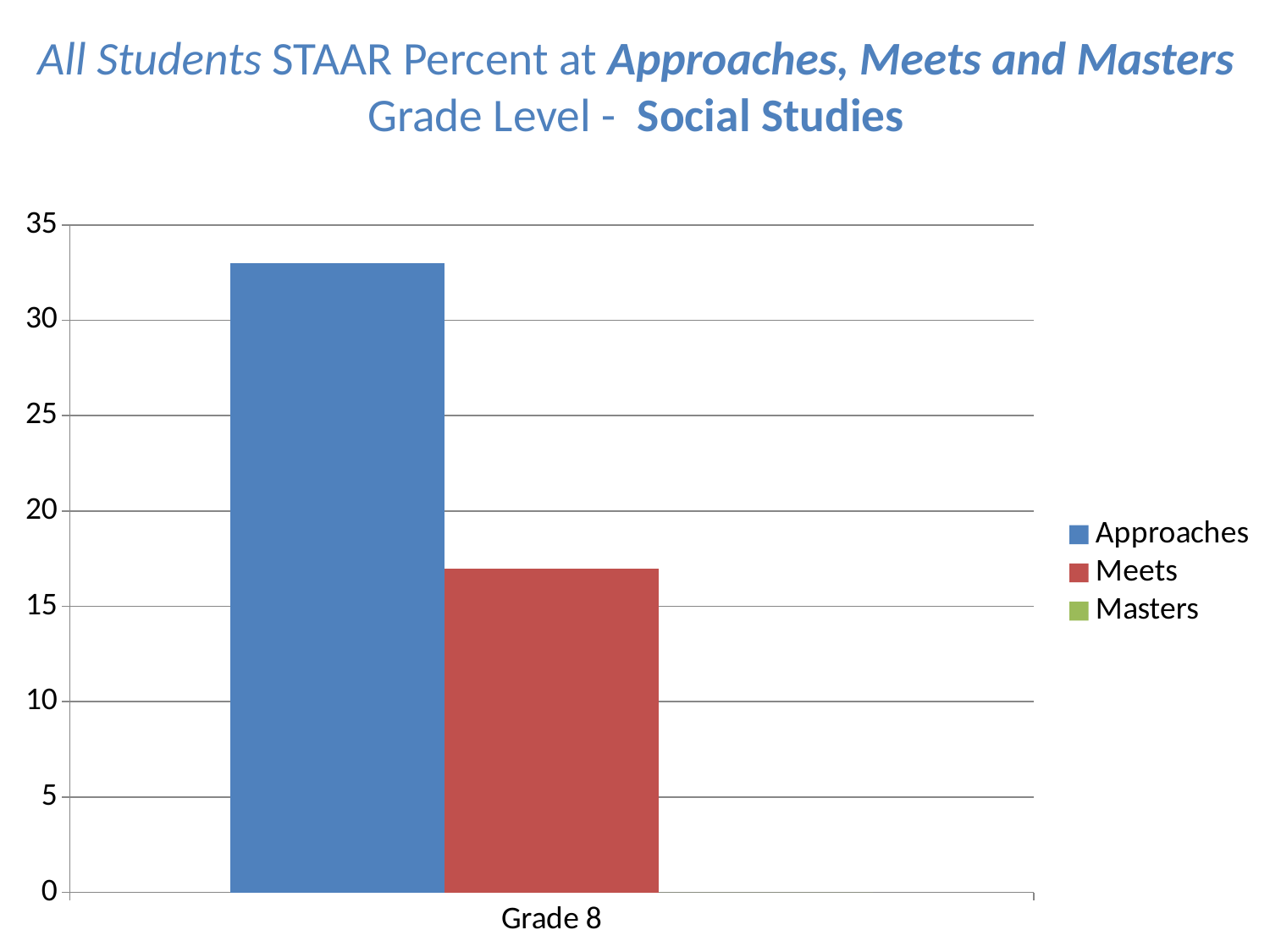
Is the value for Approaches at Grade 8 greater or less than 30? greater How many grade-level categories are shown on the x axis? 1 What colour represents the Meets series in the legend? red What kind of chart is shown on the slide? bar chart Which category label appears on the x axis? Grade 8 Is the value for Approaches at Grade 8 greater or less than 35? less Which subject does the chart title say the STAAR percentages are for? Social Studies Is the value for Meets at Grade 8 greater or less than 15? greater Which series has the tallest bar for Grade 8? Approaches How many series does the legend list? 3 Which is larger for Grade 8, Approaches or Meets? Approaches